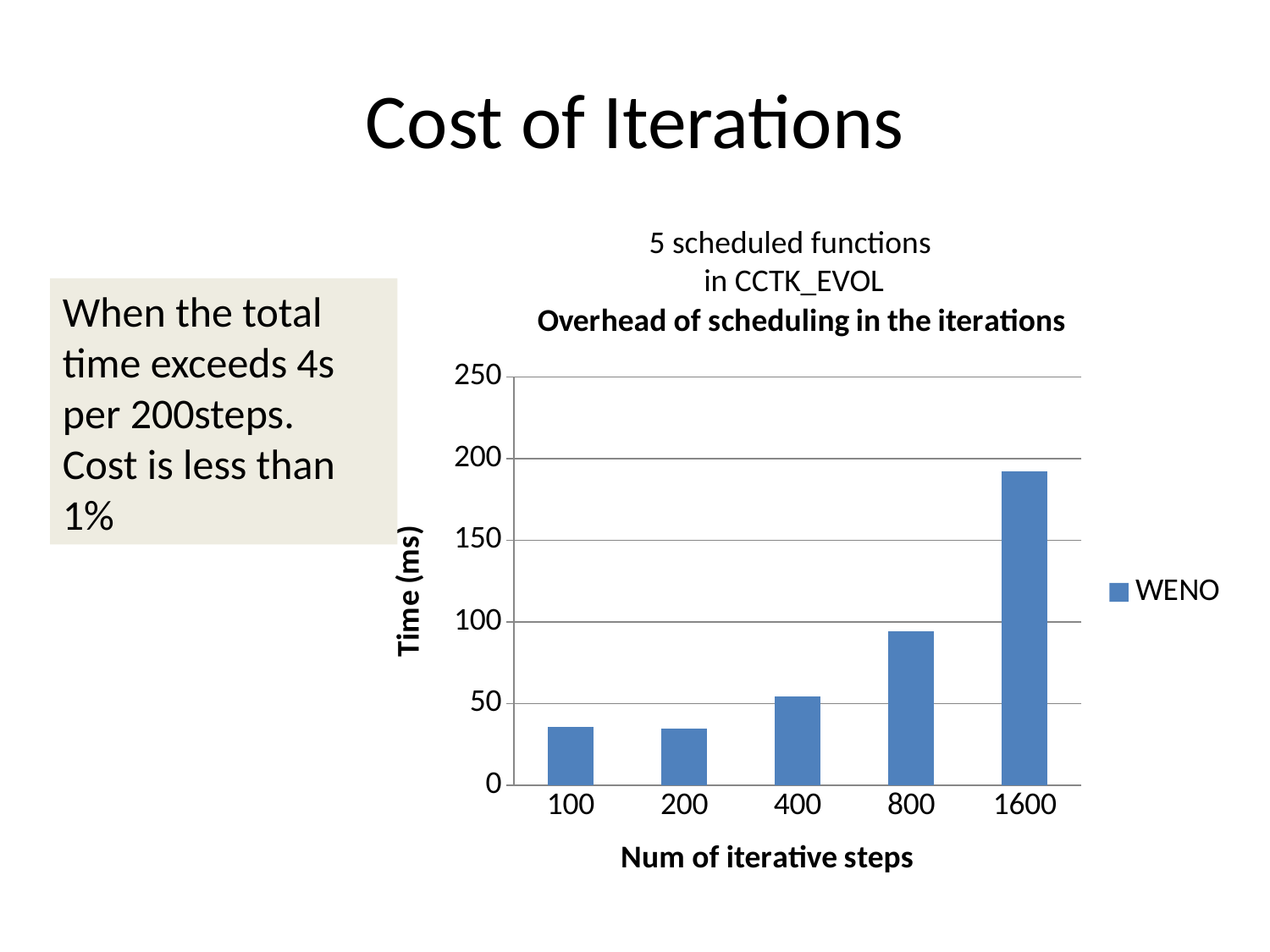
How many series does the legend list? 1 Is the value for 1600 iterative steps greater or less than 150? greater What series name appears in the legend? WENO Is the value for 100 iterative steps greater or less than 50? less What type of chart is shown on the slide? bar chart What is the title of the chart? Overhead of scheduling in the iterations Which has a larger time, 400 or 800 iterative steps? 800 Do the values rise or fall from 400 to 1600 iterative steps? rise Which number of iterative steps has the highest time? 1600 How many categories are shown on the x axis? 5 Is the value for 400 iterative steps greater or less than 100? less